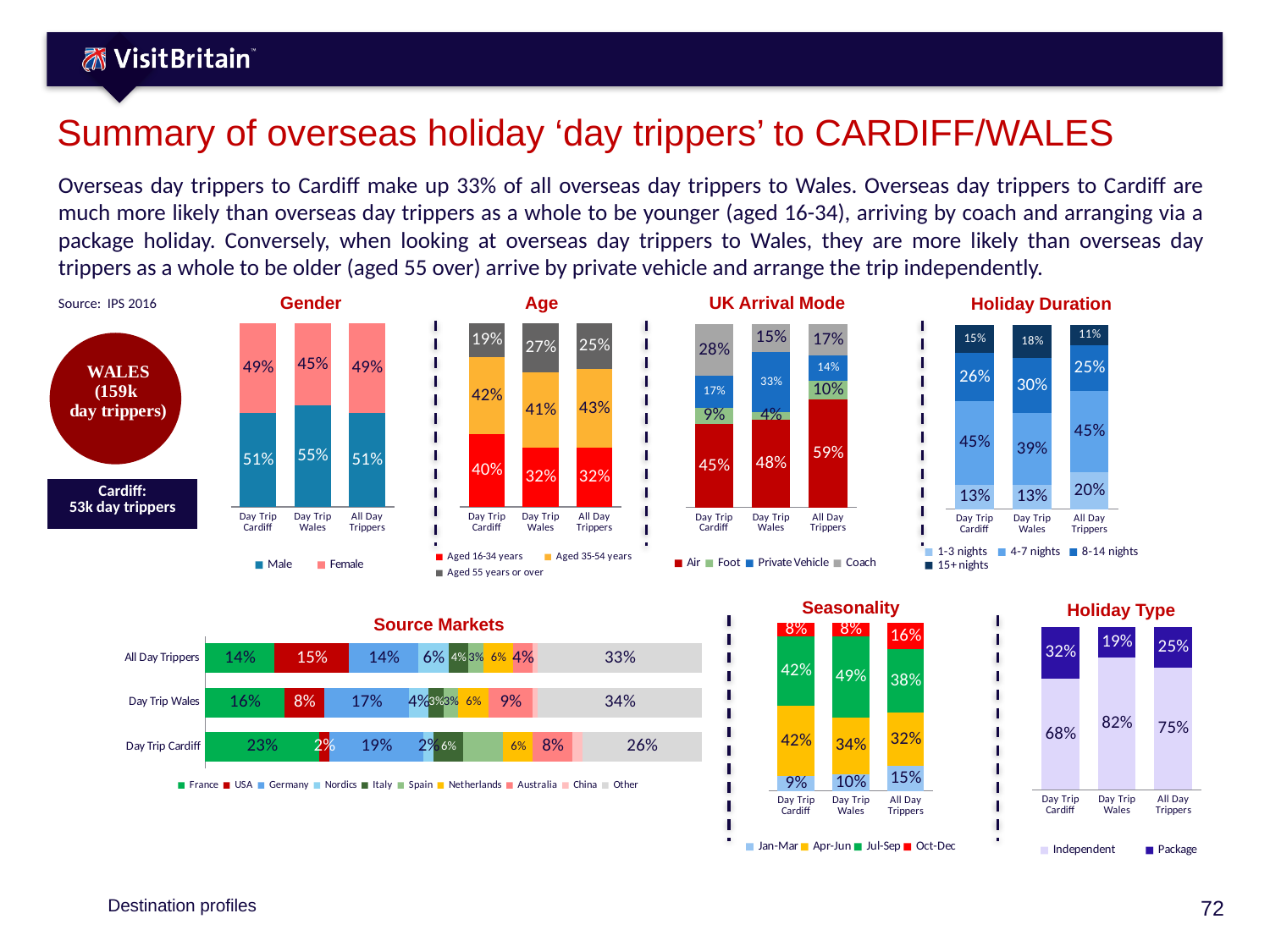
In the UK Arrival Mode chart, what percentage of Day Trip Cardiff visitors arrive by Coach? 28% In the Holiday Type chart, which is larger for Day Trip Cardiff: Independent or Package? Independent How many series does the legend of the Source Markets chart list? 10 In the Seasonality chart, what percentage of Day Trip Wales visits occur in Jul-Sep? 49% In the Age chart, which group has the highest share aged 55 years or over? Day Trip Wales In the Age chart, what share of Day Trip Cardiff visitors are aged 16-34 years? 40% In the Holiday Duration chart, which group has the lowest share staying 15+ nights? All Day Trippers In the UK Arrival Mode chart, what is the difference between the Air share for All Day Trippers and for Day Trip Cardiff? 14% In the Source Markets chart, what is the France share for Day Trip Cardiff? 23% What type of chart is the Source Markets chart? Stacked bar chart In the Holiday Duration chart, what percentage of Day Trip Wales visitors stay 4-7 nights? 39% In the Gender chart, what percentage of Day Trip Wales visitors are Male? 55%